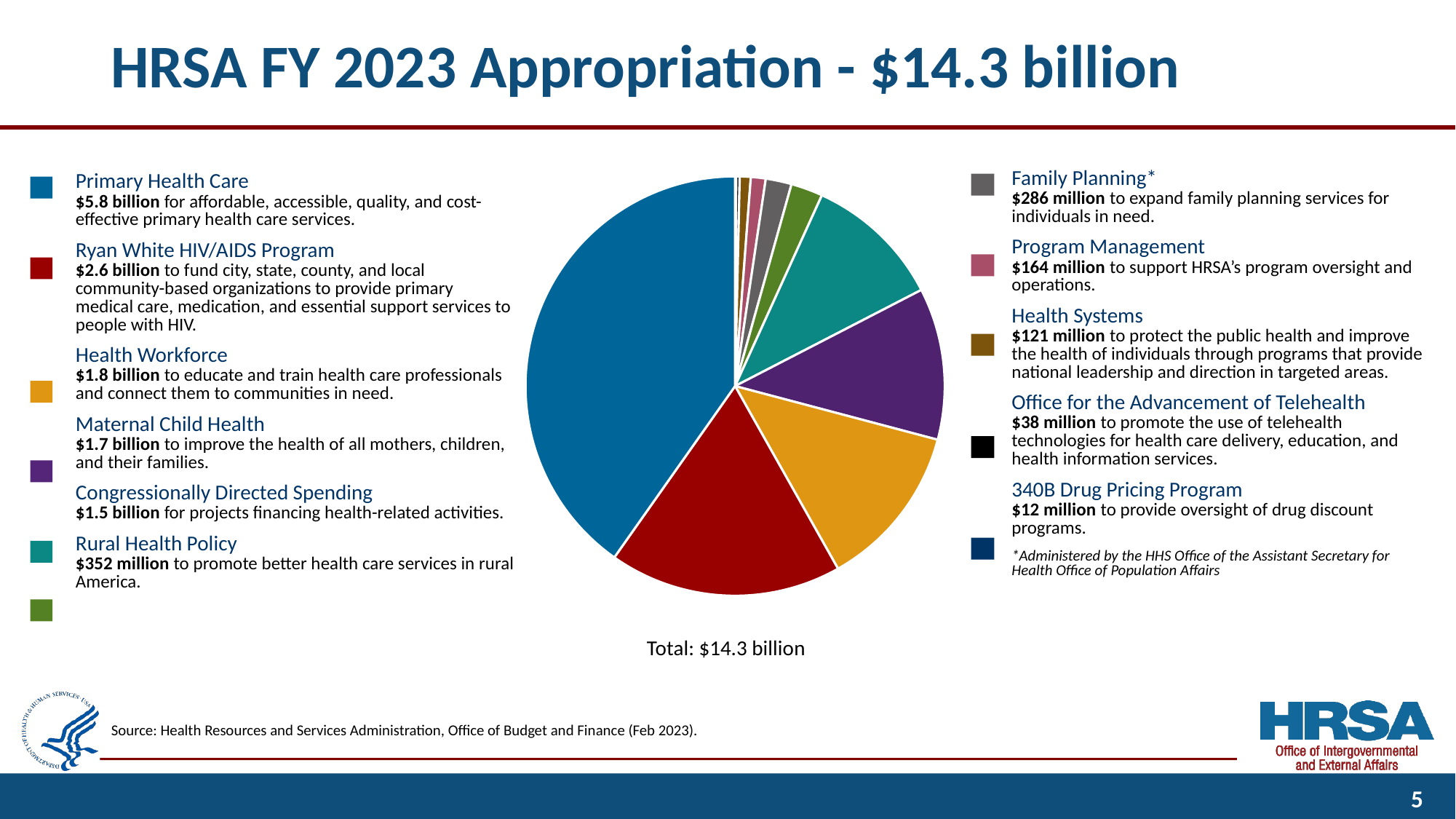
What is the appropriation for the Ryan White HIV/AIDS Program? $2.6 billion What is the total appropriation shown below the pie chart? $14.3 billion What is the appropriation for the 340B Drug Pricing Program? $12 million What colour is the slice for the Ryan White HIV/AIDS Program? Dark red Which category has the largest share of the pie chart? Primary Health Care What is the appropriation for Primary Health Care? $5.8 billion What is the appropriation for Rural Health Policy? $352 million What is the difference between the Health Workforce and Maternal Child Health appropriations? $0.1 billion Which category has the smallest appropriation? 340B Drug Pricing Program Which is larger, the appropriation for Family Planning or for Program Management? Family Planning How many categories does the pie chart have? 11 What kind of chart is shown on the slide? Pie chart